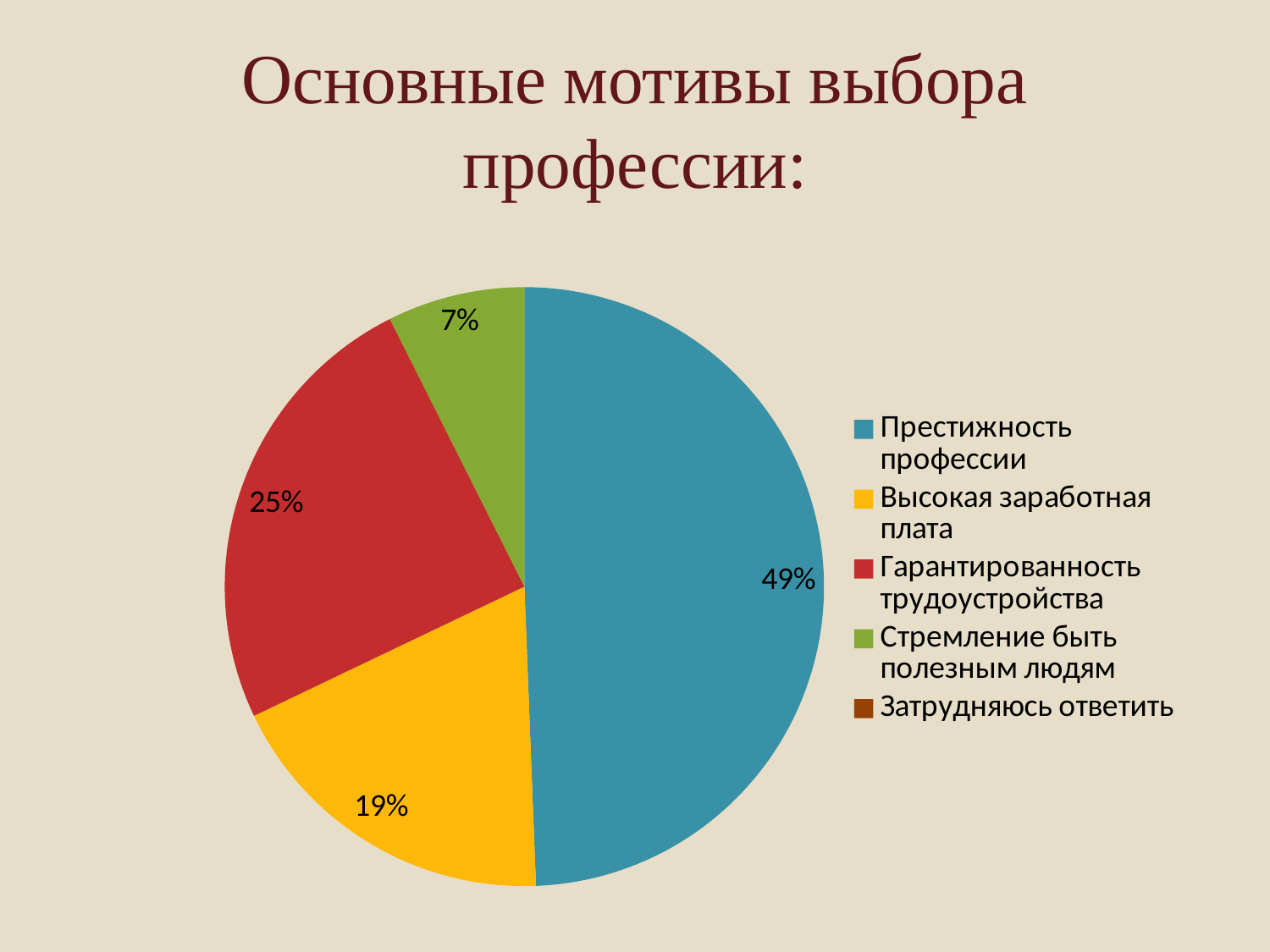
What share of the pie does "Стремление быть полезным людям" have? 7% What is the title of the slide? Основные мотивы выбора профессии: Which is larger: the share for "Гарантированность трудоустройства" or the share for "Высокая заработная плата"? Гарантированность трудоустройства Which labelled slice of the pie is the smallest? Стремление быть полезным людям What colour is the slice for "Высокая заработная плата"? yellow What share of the pie does "Гарантированность трудоустройства" have? 25% What share of the pie does "Высокая заработная плата" have? 19% What kind of chart is shown on the slide? pie chart What is the difference between the shares for "Престижность профессии" and "Гарантированность трудоустройства"? 24% How many entries does the legend list? 5 Which category has the largest slice of the pie? Престижность профессии What share of the pie does "Престижность профессии" have? 49%